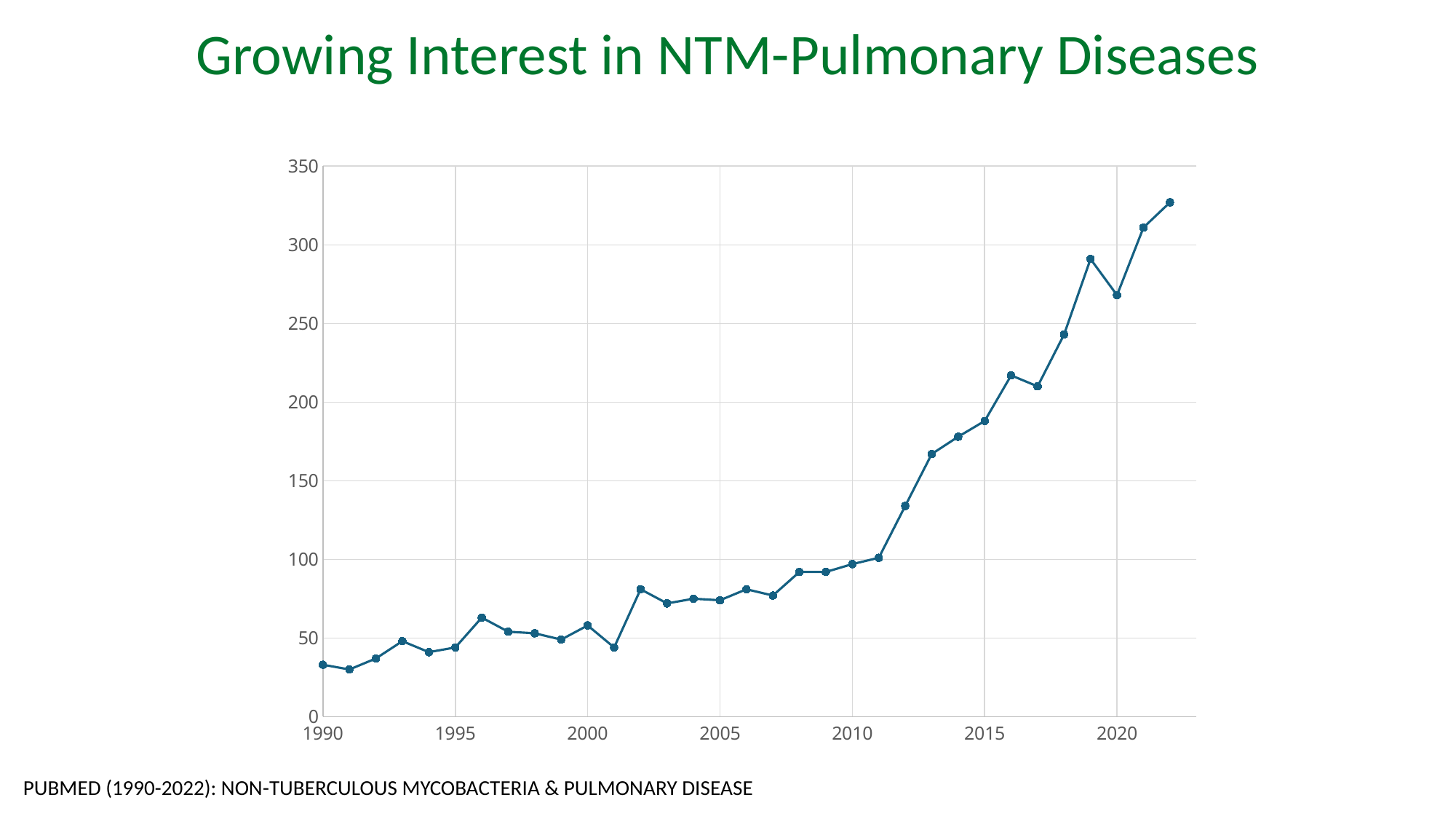
Is the value for 1990 greater or less than 50? less Is the value for 2015 greater or less than 150? greater Is the value for 2020 greater or less than 250? greater What range of years does the x axis cover according to the source note? 1990-2022 What is the title of the chart? Growing Interest in NTM-Pulmonary Diseases What kind of chart is shown on the slide? line chart Which year has the larger value, 2019 or 2020? 2019 Which year has the larger value, 2001 or 2002? 2002 Overall, do the values rise or fall from 1990 to 2022? rise Which year has the highest value on the chart? 2022